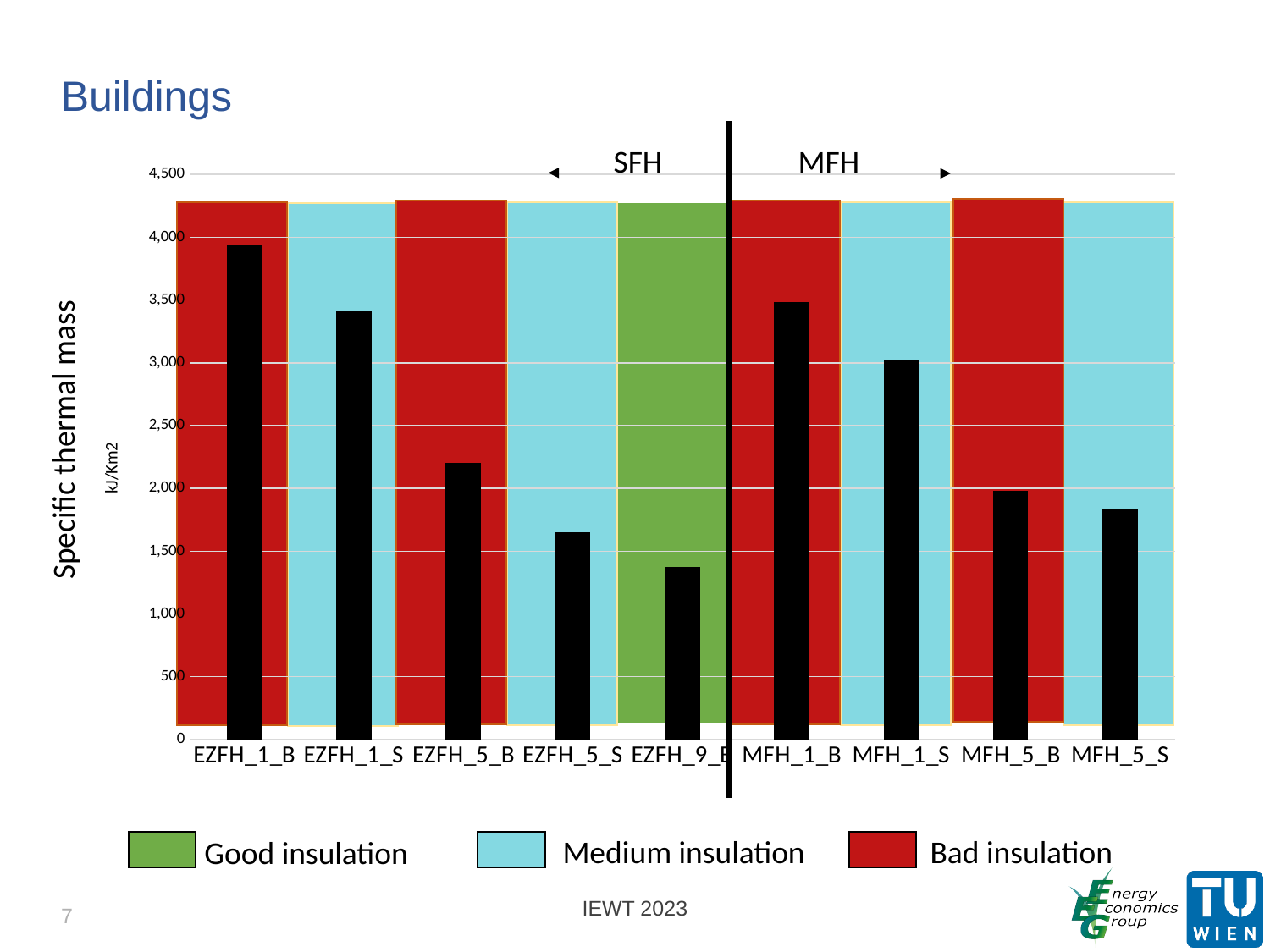
How many building categories are shown on the x axis? 9 Which building category has the highest specific thermal mass? EZFH_1_B What kind of chart is shown on the slide? bar chart Which has a higher specific thermal mass, EZFH_5_B or EZFH_5_S? EZFH_5_B Is the value for EZFH_1_B greater or less than 3,500? greater Which has a higher specific thermal mass, EZFH_1_B or MFH_1_B? EZFH_1_B Which building category has the lowest specific thermal mass? EZFH_9_B Is the value for EZFH_9_B greater or less than 1,500? less Which building category is marked with a green background indicating good insulation? EZFH_9_B What unit is shown on the y axis of the chart? kJ/Km2 Is the value for MFH_5_S greater or less than 2,000? less